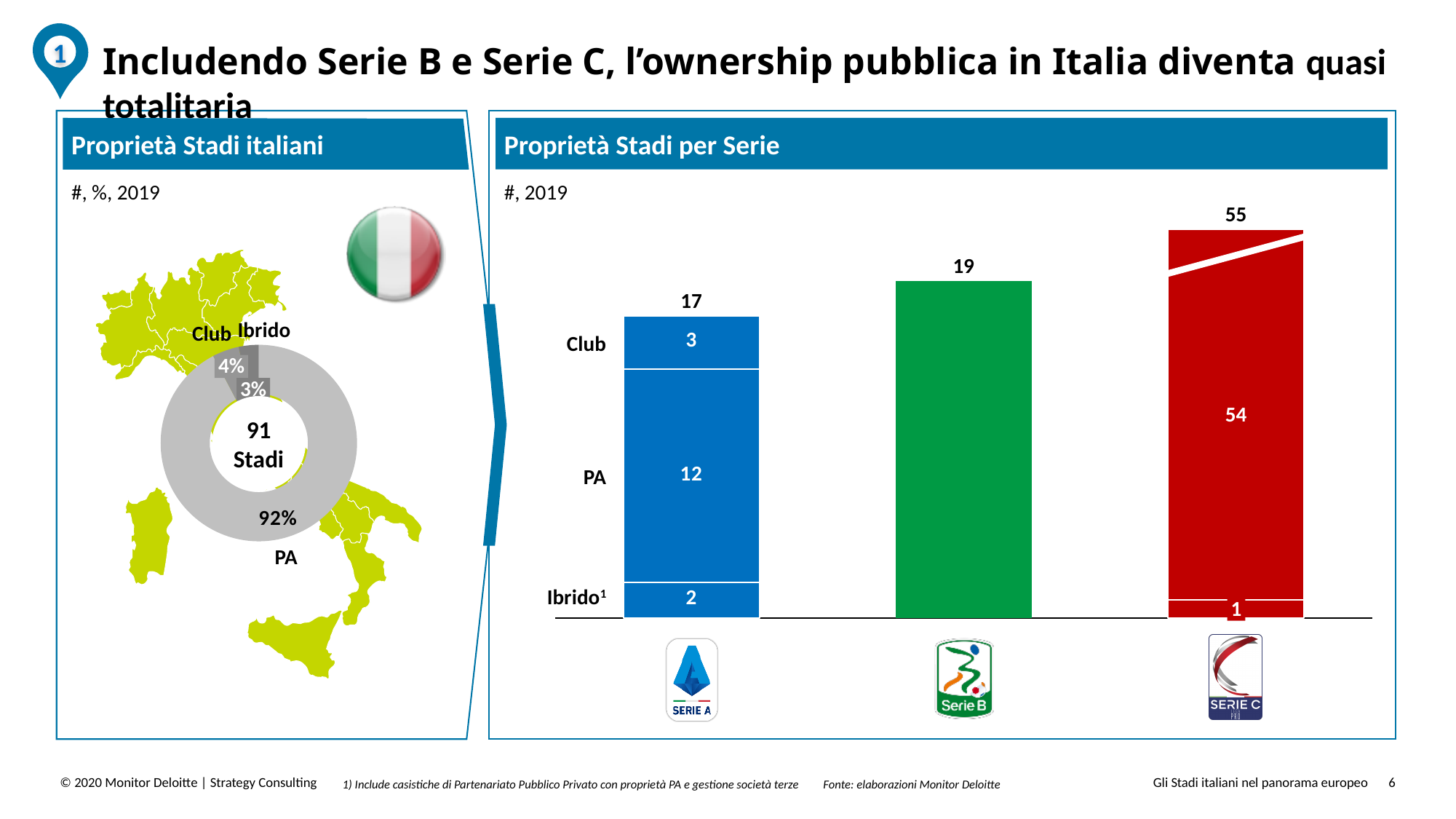
In the 'Proprietà Stadi per Serie' chart, which Serie has the lowest total number of stadiums? Serie A In the 'Proprietà Stadi per Serie' chart, what is the difference between the total for Serie C and the total for Serie B? 36 In the 'Proprietà Stadi per Serie' chart, what is the total number of stadiums for Serie C? 55 In the 'Proprietà Stadi per Serie' chart, how many Serie categories are shown on the x axis? 3 In the 'Proprietà Stadi per Serie' chart, how many Serie C stadiums are Ibrido? 1 In the 'Proprietà Stadi per Serie' chart, what is the total number of stadiums for Serie A? 17 In the 'Proprietà Stadi per Serie' chart, how many Serie A stadiums are owned by PA? 12 In the 'Proprietà Stadi italiani' chart, what is the total number of stadiums shown in the centre? 91 Stadi What kind of chart is 'Proprietà Stadi per Serie'? Stacked bar chart In the 'Proprietà Stadi italiani' chart, what share of stadiums is owned by PA? 92% In the 'Proprietà Stadi per Serie' chart, which Serie has the highest total number of stadiums? Serie C In the 'Proprietà Stadi per Serie' chart, which is larger: the number of Serie A stadiums owned by Club or by Ibrido? Club